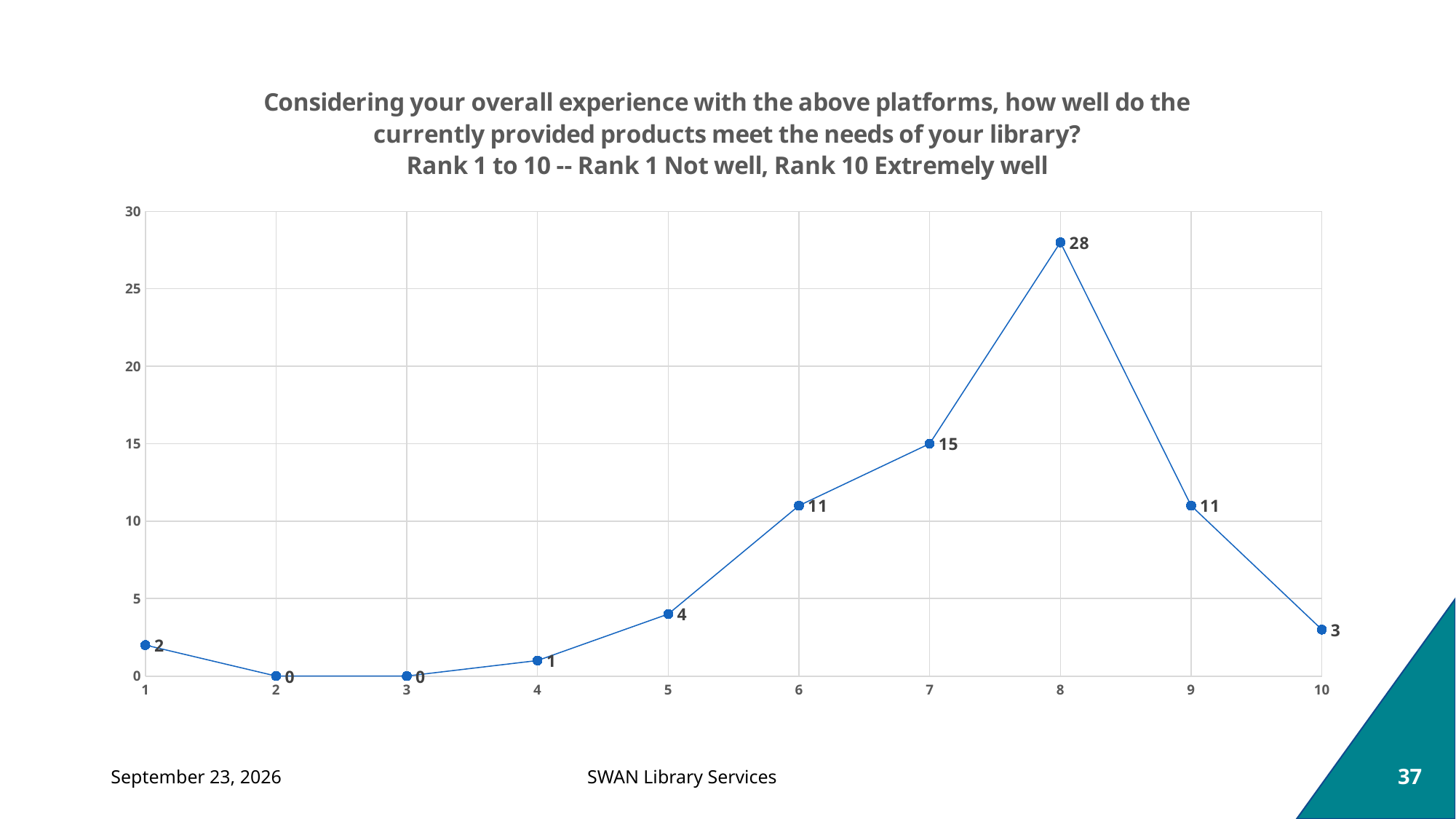
Which ranks have a value of 0? 2 and 3 What value is plotted for rank 1? 2 Which rank has the highest value? 8 What value is plotted for rank 8? 28 How many rank categories are plotted on the x axis? 10 What value is plotted for rank 5? 4 Is the value for rank 7 greater or less than 10? greater What kind of chart is shown on the slide? Line chart Do the values rise or fall from rank 8 to rank 10? Fall What is the maximum value shown on the y axis? 30 What is the difference between the values for rank 8 and rank 7? 13 Which has the larger value, rank 9 or rank 10? Rank 9